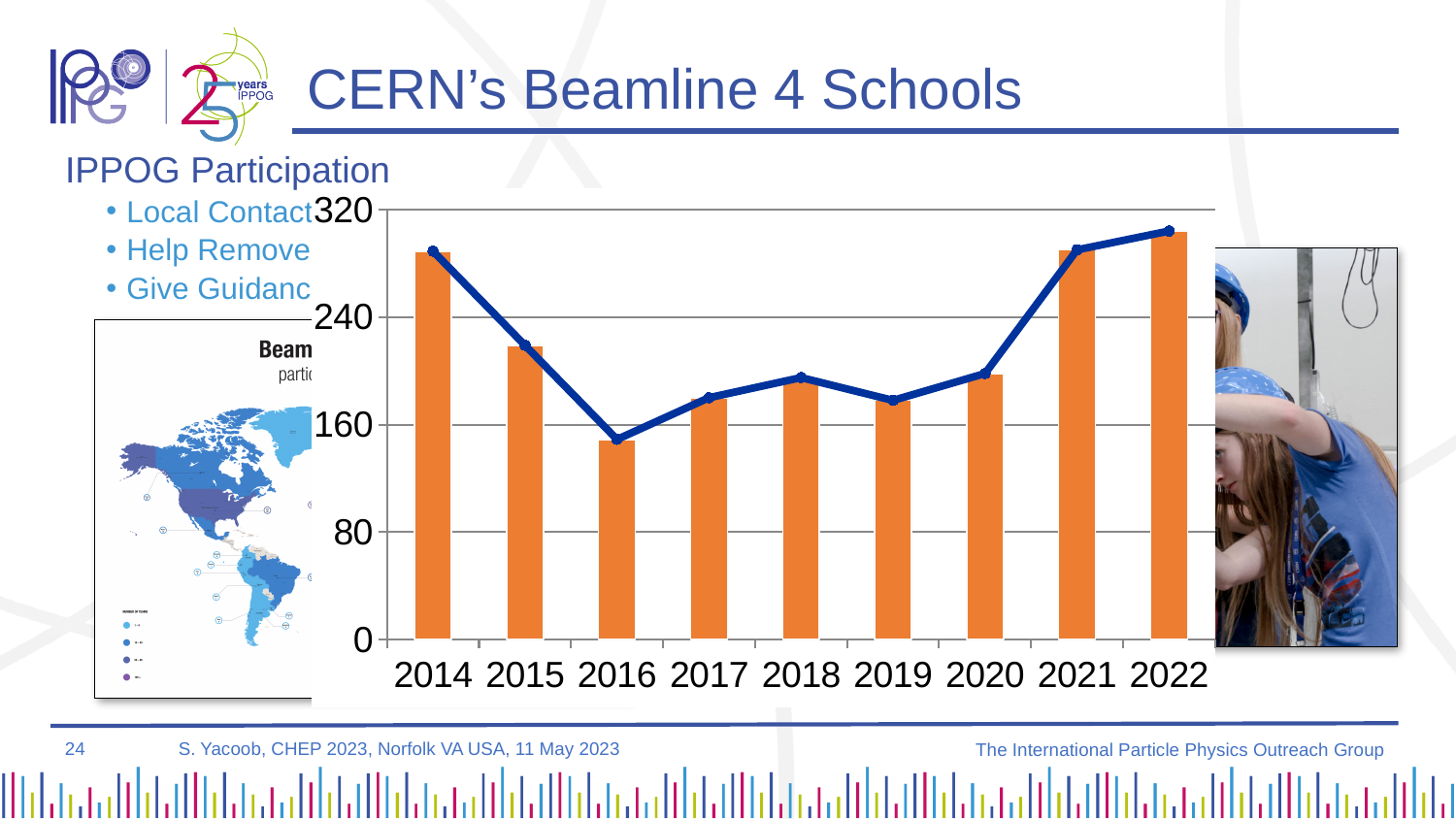
Which year has the highest value in the chart? 2022 Is the value for 2020 greater or less than 240? less What kind of chart is shown on the slide? bar chart with a line overlay Do the values rise or fall from 2014 to 2016? fall Is the value for 2018 greater or less than 160? greater How many years are shown on the x axis of the chart? 9 Which year has the larger value, 2021 or 2017? 2021 Which year has the larger value, 2015 or 2018? 2015 Is the value for 2016 greater or less than 160? less Which year has the lowest value in the chart? 2016 What colour are the bars in the chart? orange